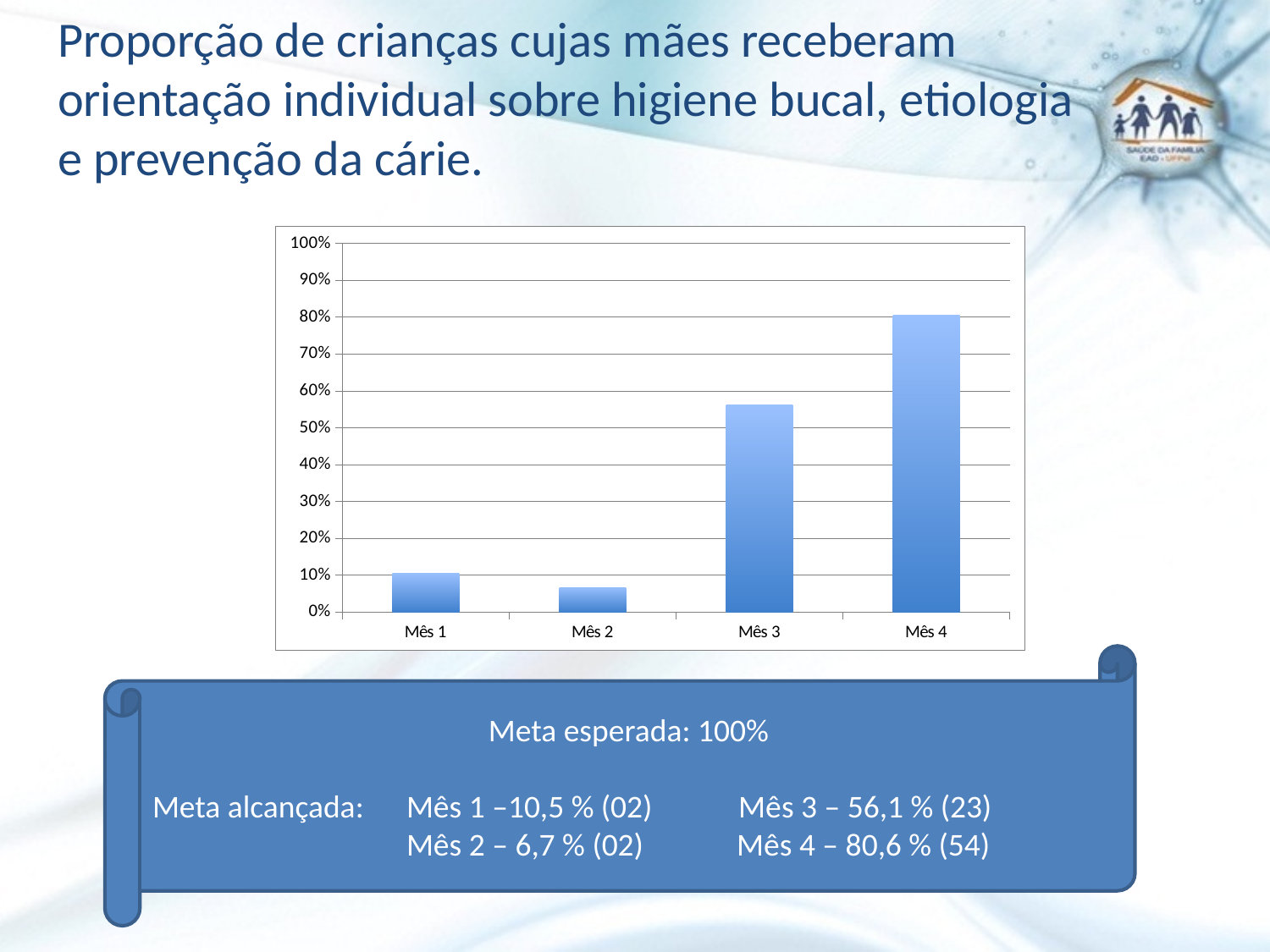
Is the value for Mês 2 greater or less than 10%? less Which month has the lowest bar on the chart? Mês 2 According to the slide, what proportion was reached in Mês 3? 56,1 % Which is larger, the value for Mês 1 or the value for Mês 2? Mês 1 Is the value for Mês 3 greater or less than 50%? greater According to the slide, what proportion was reached in Mês 1? 10,5 % What is the difference between the values for Mês 4 and Mês 3 as given on the slide? 24,5 % What kind of chart is shown on the slide? bar chart How many categories (months) are plotted on the chart? 4 Which month has the highest bar on the chart? Mês 4 According to the slide, what proportion was reached in Mês 4? 80,6 % What is the expected target (meta esperada) stated on the slide? 100%